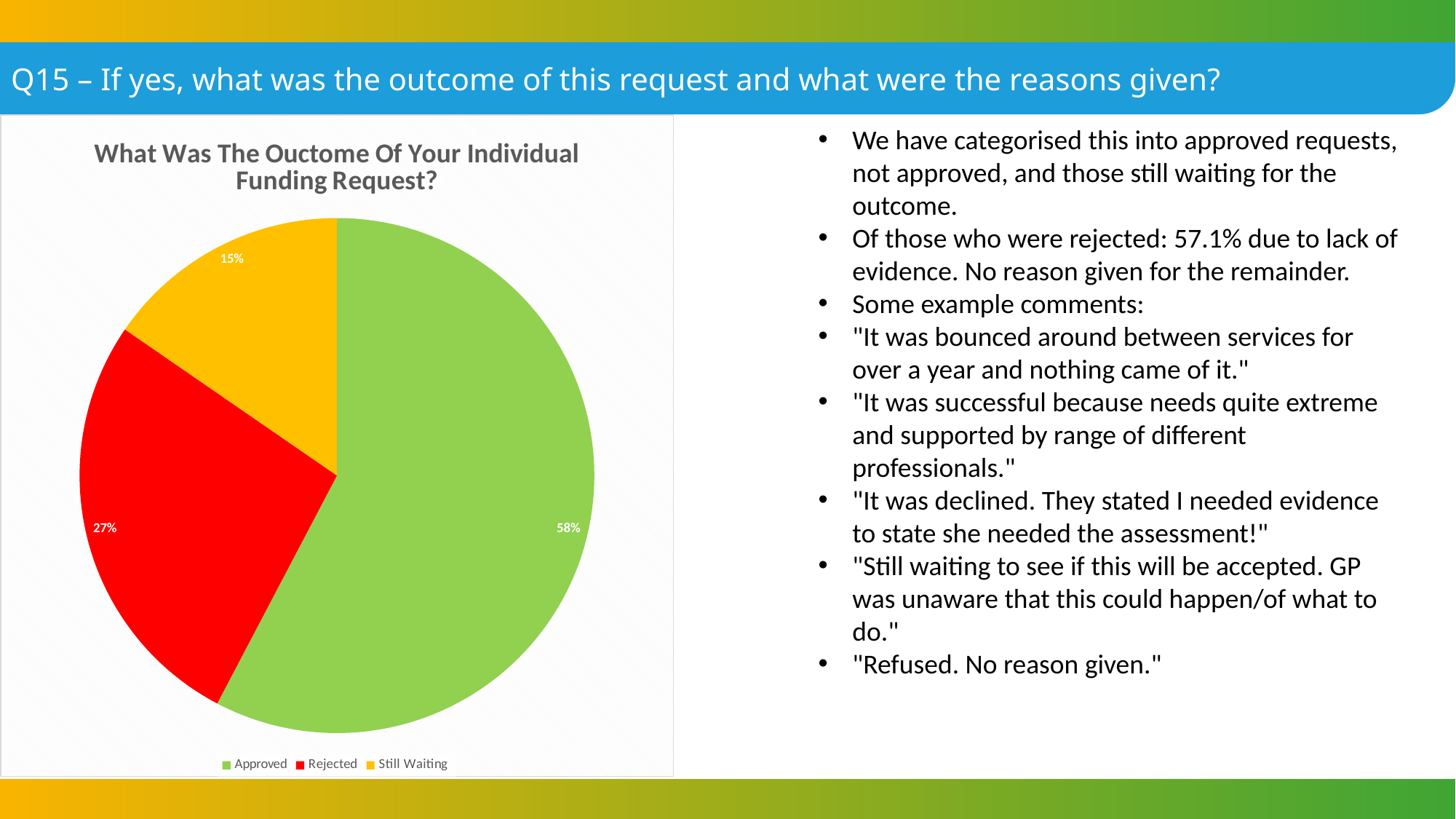
Which outcome category has the smallest share of the pie? Still Waiting What type of chart is shown on the slide? pie chart Which is larger, the Rejected share or the Still Waiting share? Rejected Which outcome category has the largest share of the pie? Approved What percentage of individual funding requests were Approved? 58% What is the title of the chart? What Was The Ouctome Of Your Individual Funding Request? What is the difference in percentage points between Approved and Rejected? 31 What percentage of respondents are Still Waiting for an outcome? 15% How many categories does the pie chart show? 3 What colour is the Approved slice? green What percentage of individual funding requests were Rejected? 27% What is the difference in percentage points between Rejected and Still Waiting? 12